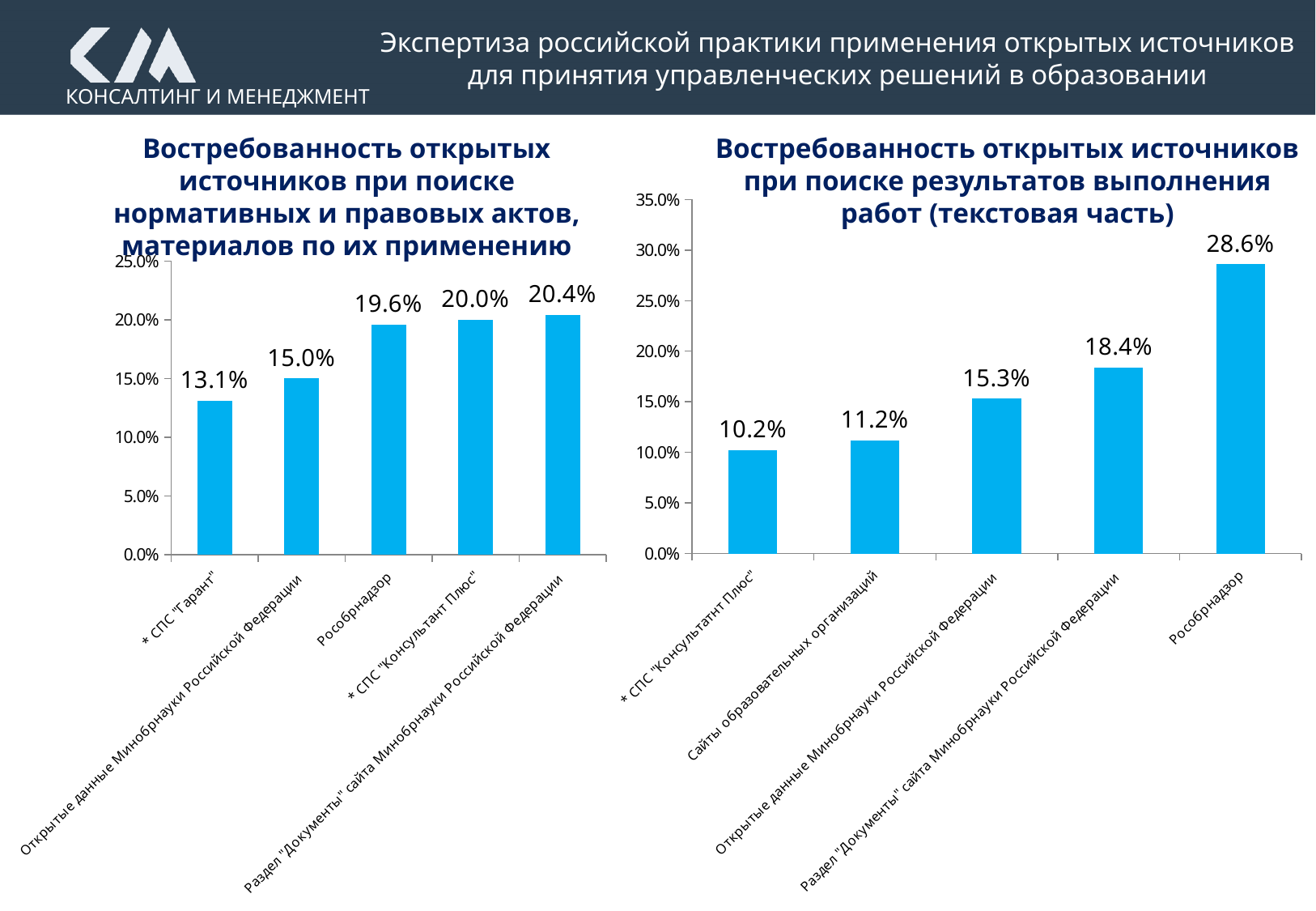
In the right chart, which category has the lowest value? * СПС "Консультатнт Плюс" In the right chart, which is larger: the value for Открытые данные Минобрнауки Российской Федерации or the value for Раздел "Документы" сайта Минобрнауки Российской Федерации? Раздел "Документы" сайта Минобрнауки Российской Федерации What type of chart is the left chart? Bar chart How many categories are shown in the right chart? 5 In the left chart, what is the value for Рособрнадзор? 19.6% In the right chart, what is the difference between the values for Рособрнадзор and * СПС "Консультатнт Плюс"? 18.4% In the left chart, what is the difference between the values for * СПС "Консультант Плюс" and Открытые данные Минобрнауки Российской Федерации? 5.0% In the left chart, which category has the lowest value? * СПС "Гарант" In the right chart, what is the value for Рособрнадзор? 28.6% In the right chart, what is the value for Сайты образовательных организаций? 11.2% In the left chart, what is the value for * СПС "Гарант"? 13.1% In the left chart, which category has the highest value? Раздел "Документы" сайта Минобрнауки Российской Федерации